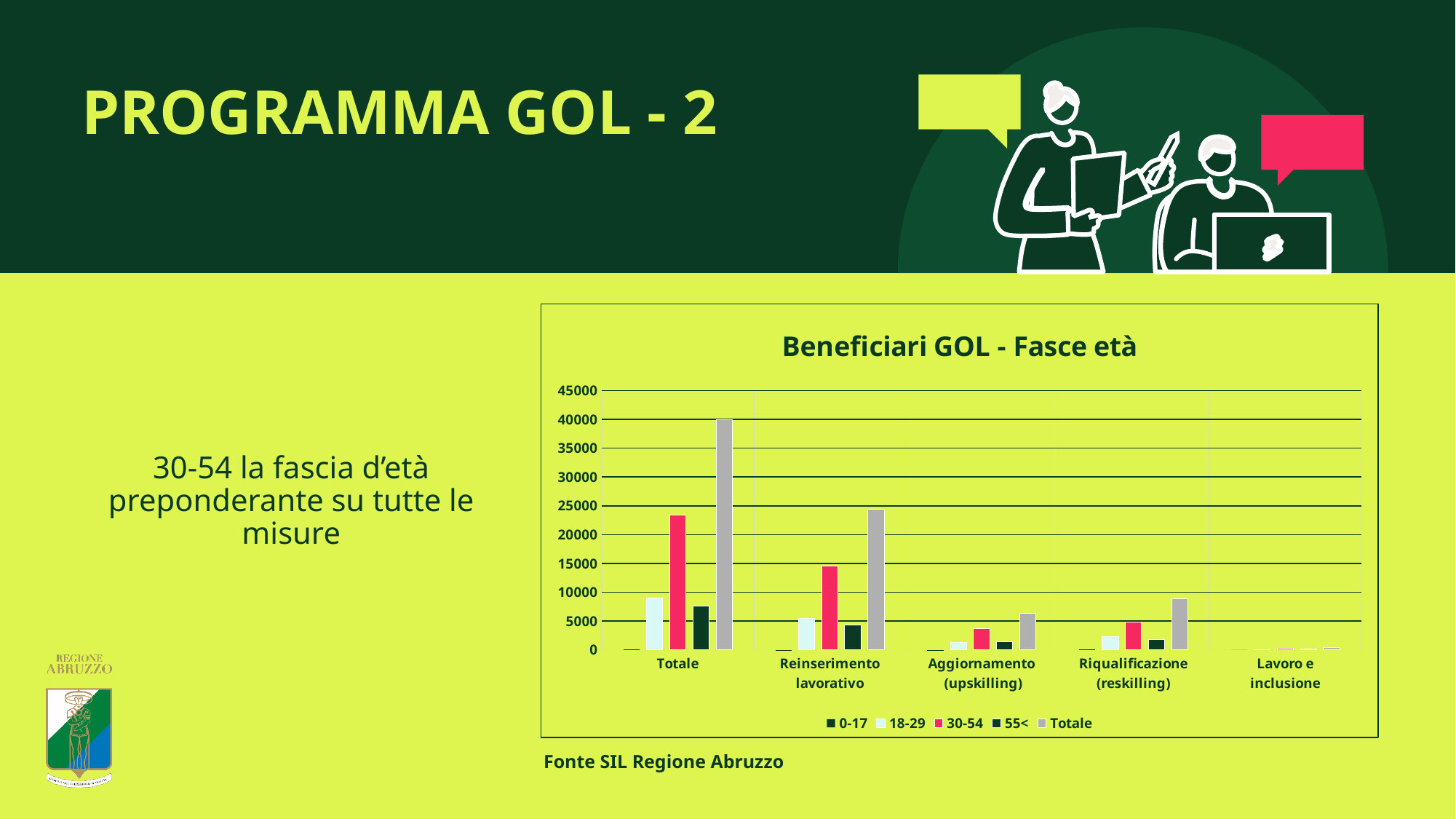
How many series does the chart legend list? 5 Which category has the lowest Totale bar? Lavoro e inclusione Is the Totale value for 'Reinserimento lavorativo' greater or less than 20000? greater What type of chart is shown on the slide? bar chart How many categories are shown along the x axis of the chart? 5 Is the 30-54 value for the 'Totale' category greater or less than 20000? greater Which age group series has the tallest bar in the 'Totale' category (excluding the Totale series)? 30-54 Is the Totale value for the 'Totale' category greater or less than 35000? greater Which has a larger 30-54 value: 'Aggiornamento (upskilling)' or 'Riqualificazione (reskilling)'? Riqualificazione (reskilling) What is the title of the chart? Beneficiari GOL - Fasce età Which has a larger Totale value: 'Reinserimento lavorativo' or 'Riqualificazione (reskilling)'? Reinserimento lavorativo